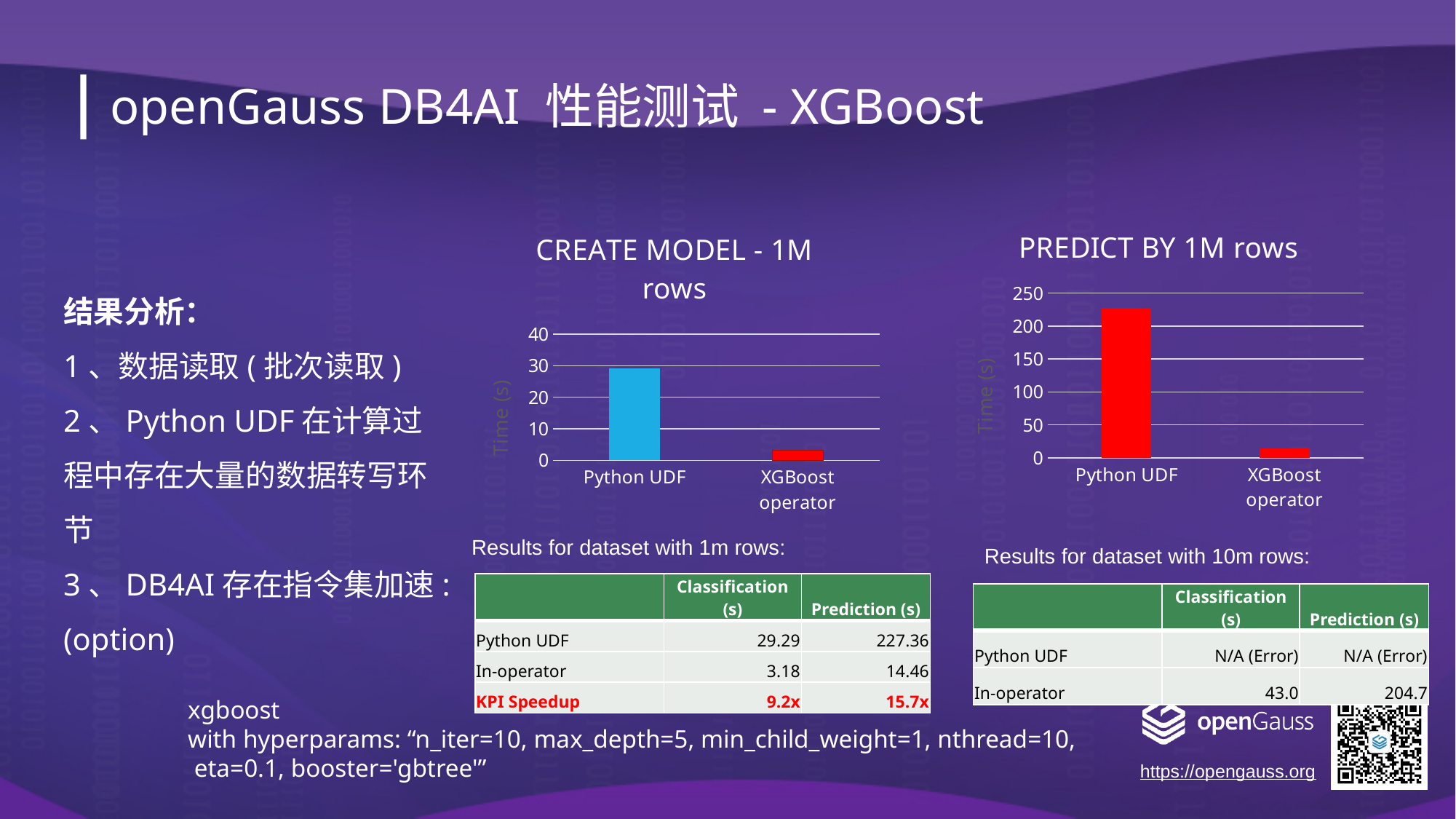
In the PREDICT BY 1M rows chart, is the value for XGBoost operator greater or less than 50? less In the CREATE MODEL - 1M rows chart, is the value for Python UDF greater or less than 20? greater In the CREATE MODEL - 1M rows chart, which category has the lowest value? XGBoost operator In the PREDICT BY 1M rows chart, which is larger, Python UDF or XGBoost operator? Python UDF In the PREDICT BY 1M rows chart, is the value for Python UDF greater or less than 200? greater In the PREDICT BY 1M rows chart, which category has the highest value? Python UDF In the CREATE MODEL - 1M rows chart, which category has the highest value? Python UDF What kind of chart is the PREDICT BY 1M rows chart? bar chart What is the highest y-axis tick value shown on the PREDICT BY 1M rows chart? 250 How many categories are shown in the CREATE MODEL - 1M rows chart? 2 What is the y-axis label of the CREATE MODEL - 1M rows chart? Time (s)